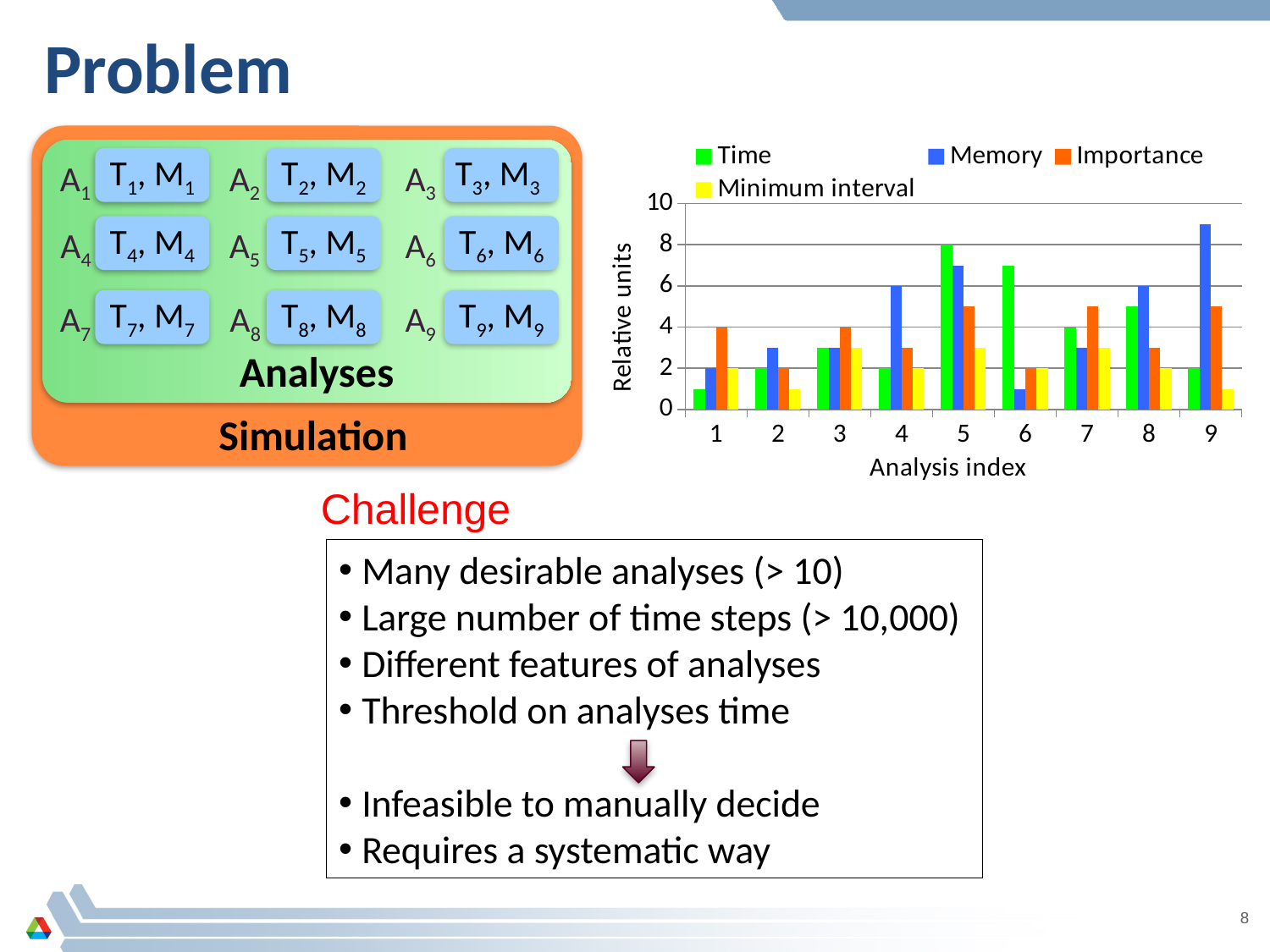
What is the title of the chart's vertical axis? Relative units What is the Time value for analysis index 5? 8 How many analysis indices are shown on the x axis of the chart? 9 At which analysis index is the Time value highest? 5 How many series does the chart legend list? 4 Is the Memory value for analysis index 9 greater or less than 8? greater At analysis index 9, which is larger: the Memory value or the Time value? Memory At which analysis index is the Memory value highest? 9 What kind of chart is shown on the slide? bar chart What is the Importance value for analysis index 1? 4 Is the Memory value for analysis index 6 greater or less than 2? less What is the Memory value for analysis index 4? 6